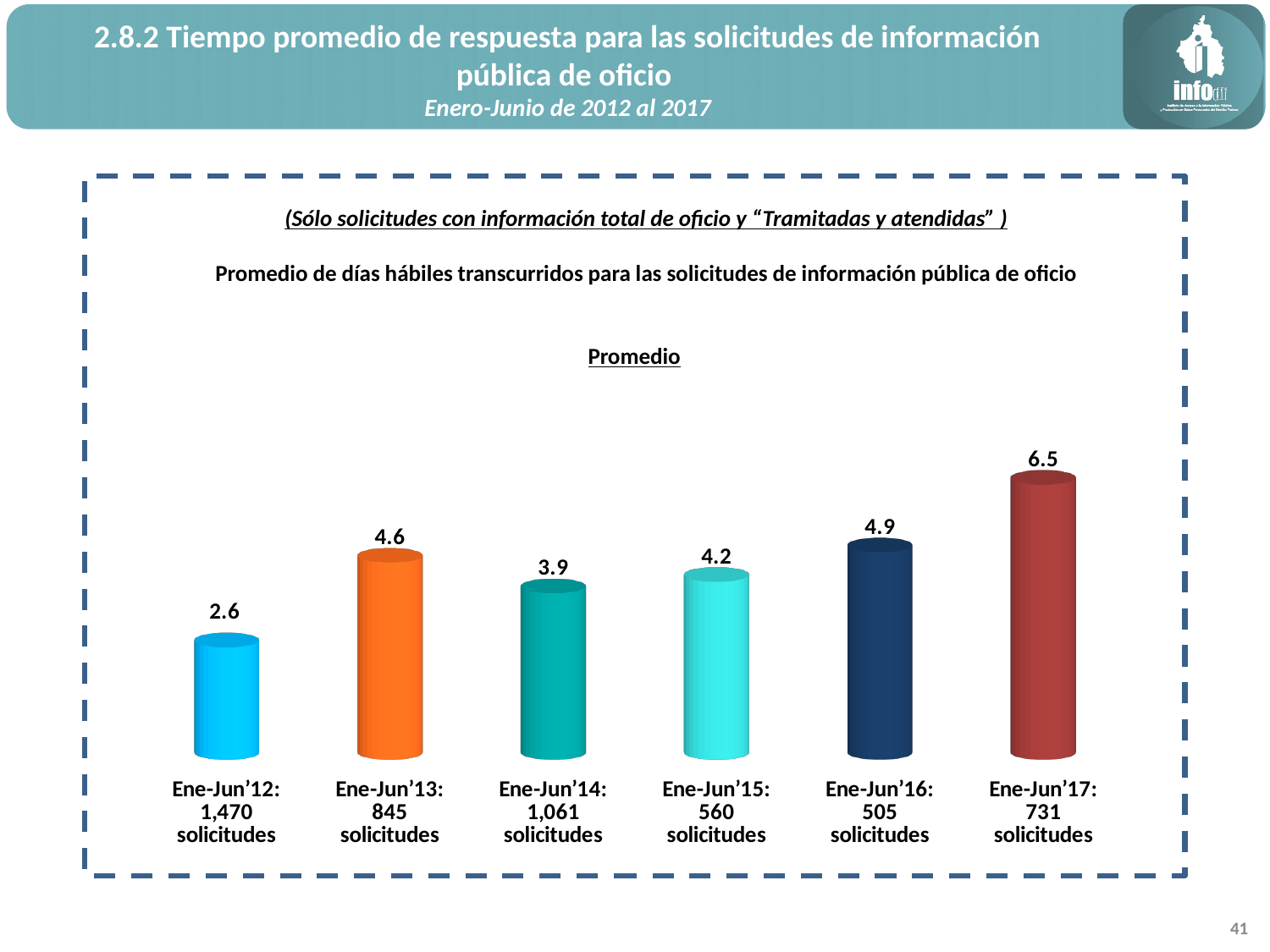
What is the average value shown for Ene-Jun'14? 3.9 Which period has the highest average? Ene-Jun'17 What is the difference between the averages for Ene-Jun'13 and Ene-Jun'14? 0.7 What is the average value shown for Ene-Jun'12? 2.6 How many periods are plotted in the chart? 6 Which period has the lowest average? Ene-Jun'12 Which is larger, the average for Ene-Jun'13 or for Ene-Jun'15? Ene-Jun'13 How many solicitudes are indicated in the label for Ene-Jun'12? 1,470 What is the average value shown for Ene-Jun'16? 4.9 What is the difference between the averages for Ene-Jun'17 and Ene-Jun'12? 3.9 What is the underlined label above the bars in the chart? Promedio What kind of chart is shown on the slide? Bar chart